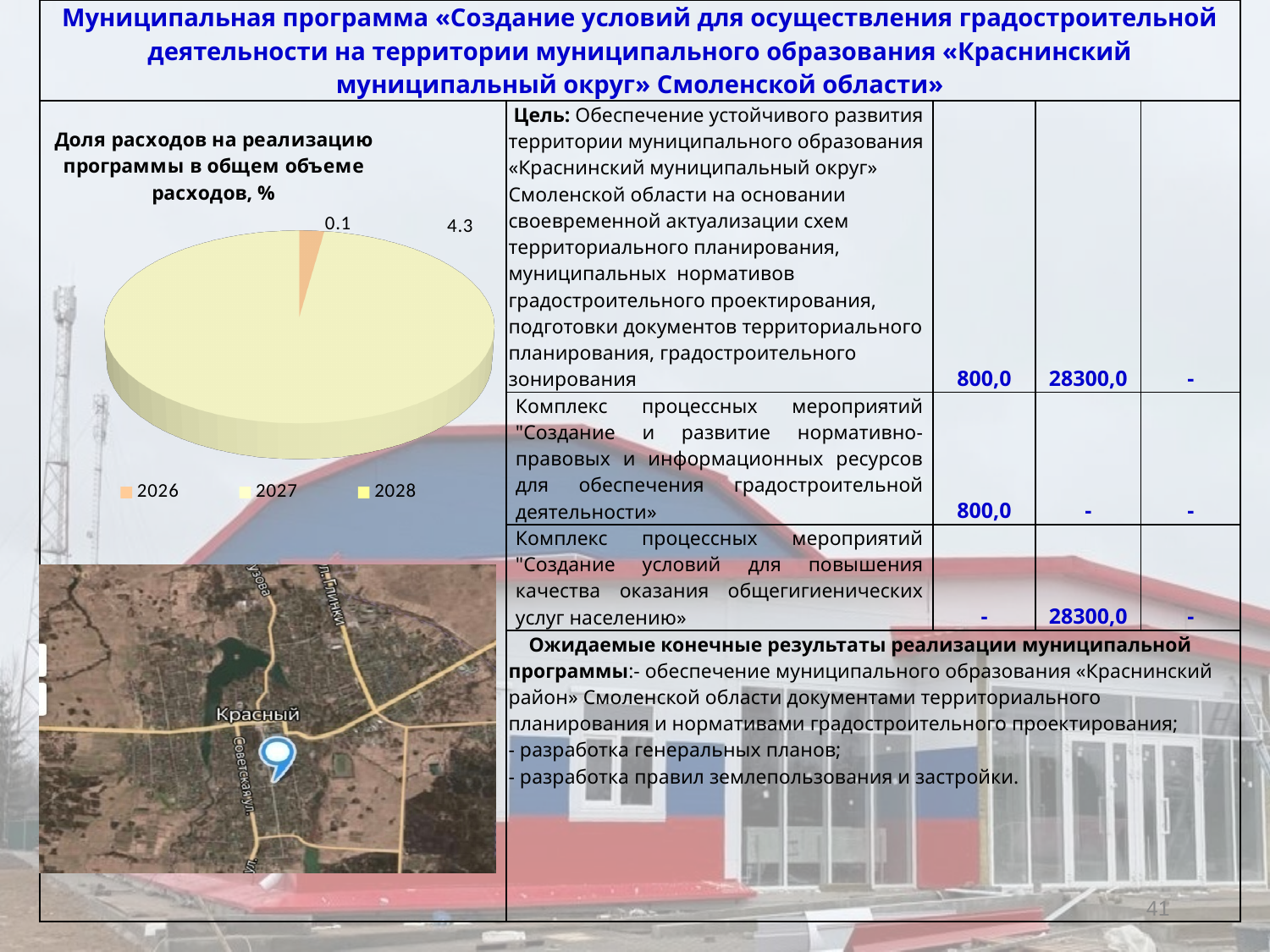
Which year has the largest slice in the pie chart? 2027 Which is larger in the pie chart, the value for 2026 or the value for 2027? 2027 What is the difference between the values for 2027 and 2026 in the pie chart? 4.2 What kind of chart is shown on the slide? pie chart What value is shown for 2027 in the pie chart? 4.3 Which years are listed in the chart's legend? 2026, 2027, 2028 What value is shown for 2026 in the pie chart? 0.1 How many entries does the chart's legend list? 3 What is the title of the chart on the slide? Доля расходов на реализацию программы в общем объеме расходов, % How many data labels are printed on the pie chart? 2